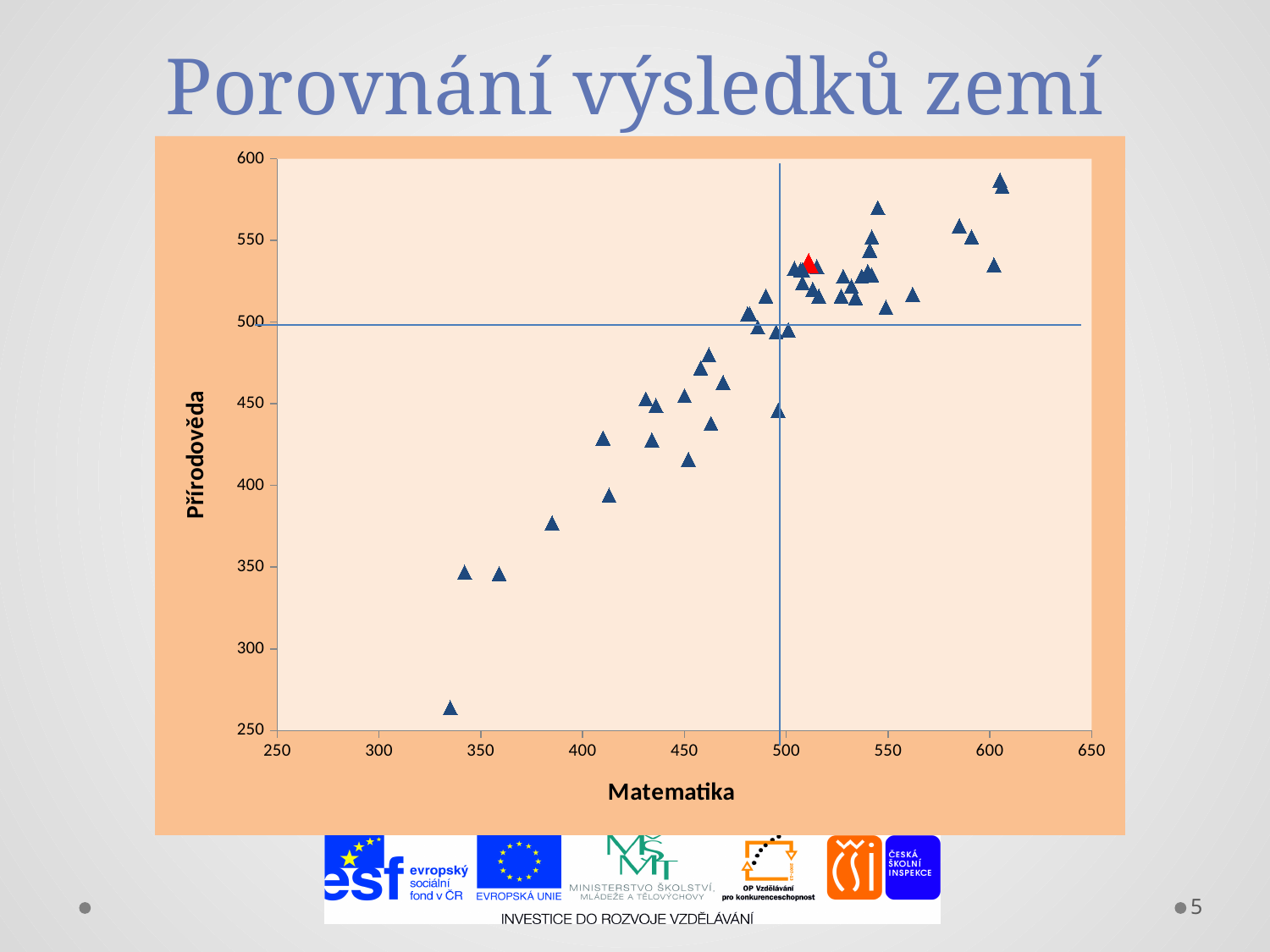
Which has the higher Přírodověda value, the red point or the lowest blue point on the chart? the red point Is the Matematika value of the leftmost point on the chart greater or less than 350? less Is the Přírodověda value of the highest point on the chart greater or less than 550? greater Is the Přírodověda value of the lowest point on the chart greater or less than 300? less Do the Přírodověda values generally rise or fall as the Matematika values increase along the x axis? rise What is the title of the horizontal axis of the chart? Matematika What kind of chart is shown on the slide? scatter plot What is the title of the vertical axis of the chart? Přírodověda